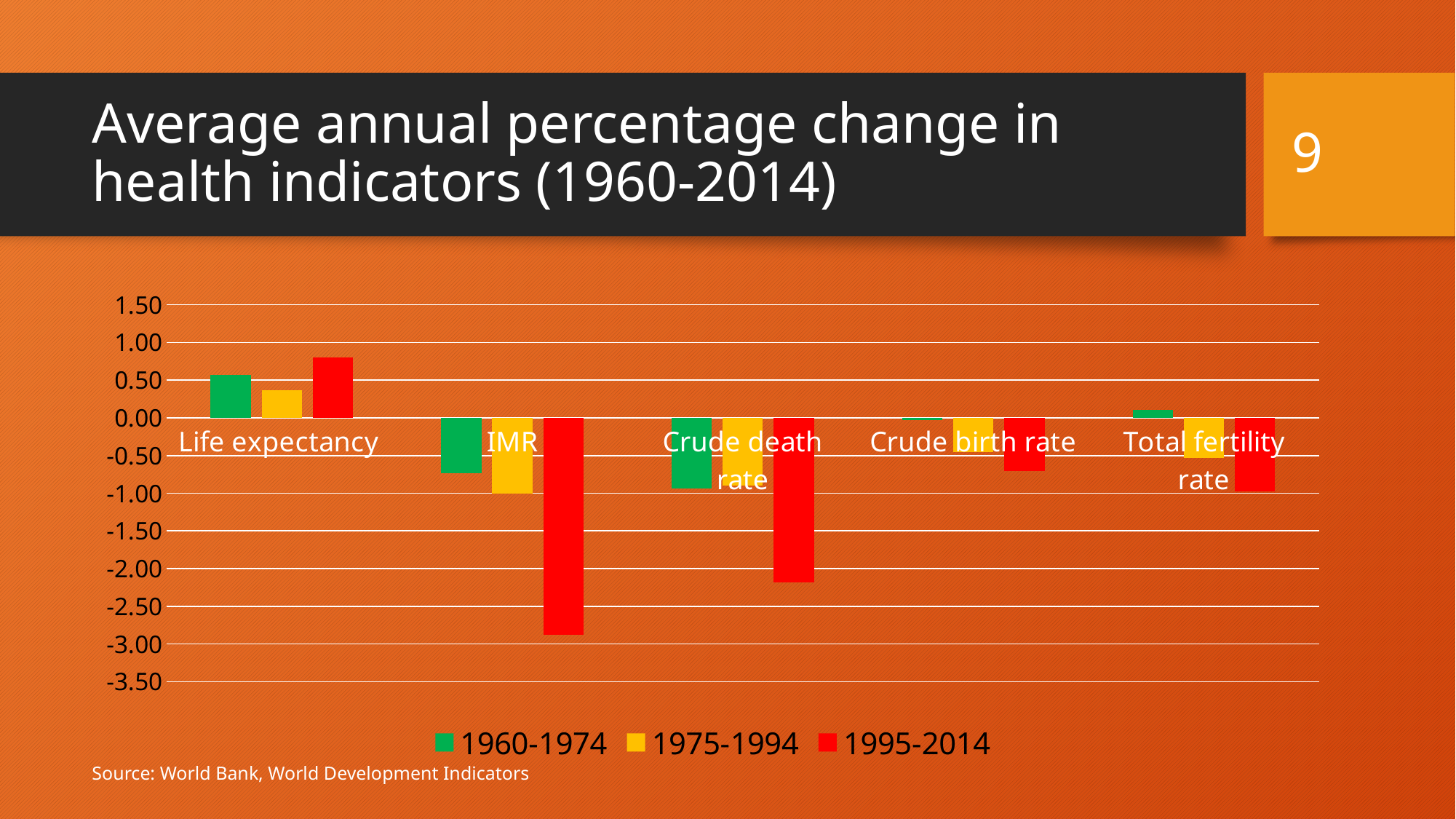
Which category has the highest value for the 1995-2014 series? Life expectancy Which category has the lowest value for the 1995-2014 series? IMR What kind of chart is shown on the slide? bar chart Is the 1995-2014 value for Crude death rate greater or less than -2.00? less Is the 1975-1994 value for IMR greater or less than -0.50? less For Life expectancy, which series has the largest value? 1995-2014 Is the 1995-2014 value for IMR greater or less than -2.50? less How many health indicator categories are shown on the x axis? 5 How many series does the legend list? 3 For Life expectancy, which is larger: the 1960-1974 value or the 1975-1994 value? 1960-1974 What colour represents the 1995-2014 series in the legend? red